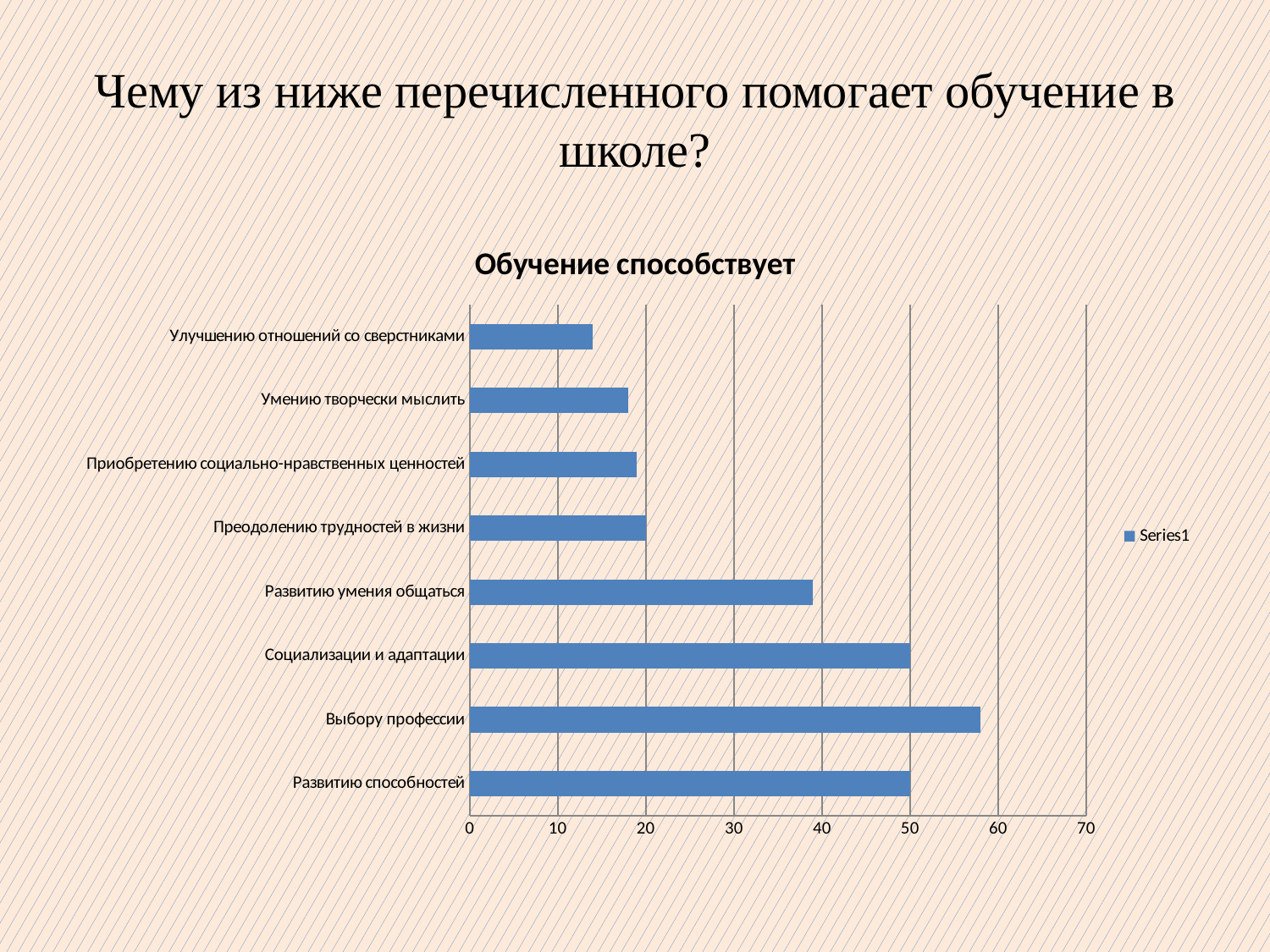
Is the value for Умению творчески мыслить greater or less than 20? less Is the value for Выбору профессии greater or less than 50? greater Which is larger: the value for Развитию умения общаться or the value for Преодолению трудностей в жизни? Развитию умения общаться Which category has the lowest value? Улучшению отношений со сверстниками Which category has the highest value? Выбору профессии What is the value for Социализации и адаптации? 50 What type of chart is shown on the slide? Bar chart How many series does the legend list? 1 What is the title of the chart? Обучение способствует What is the value for Развитию способностей? 50 How many categories are plotted in the chart? 8